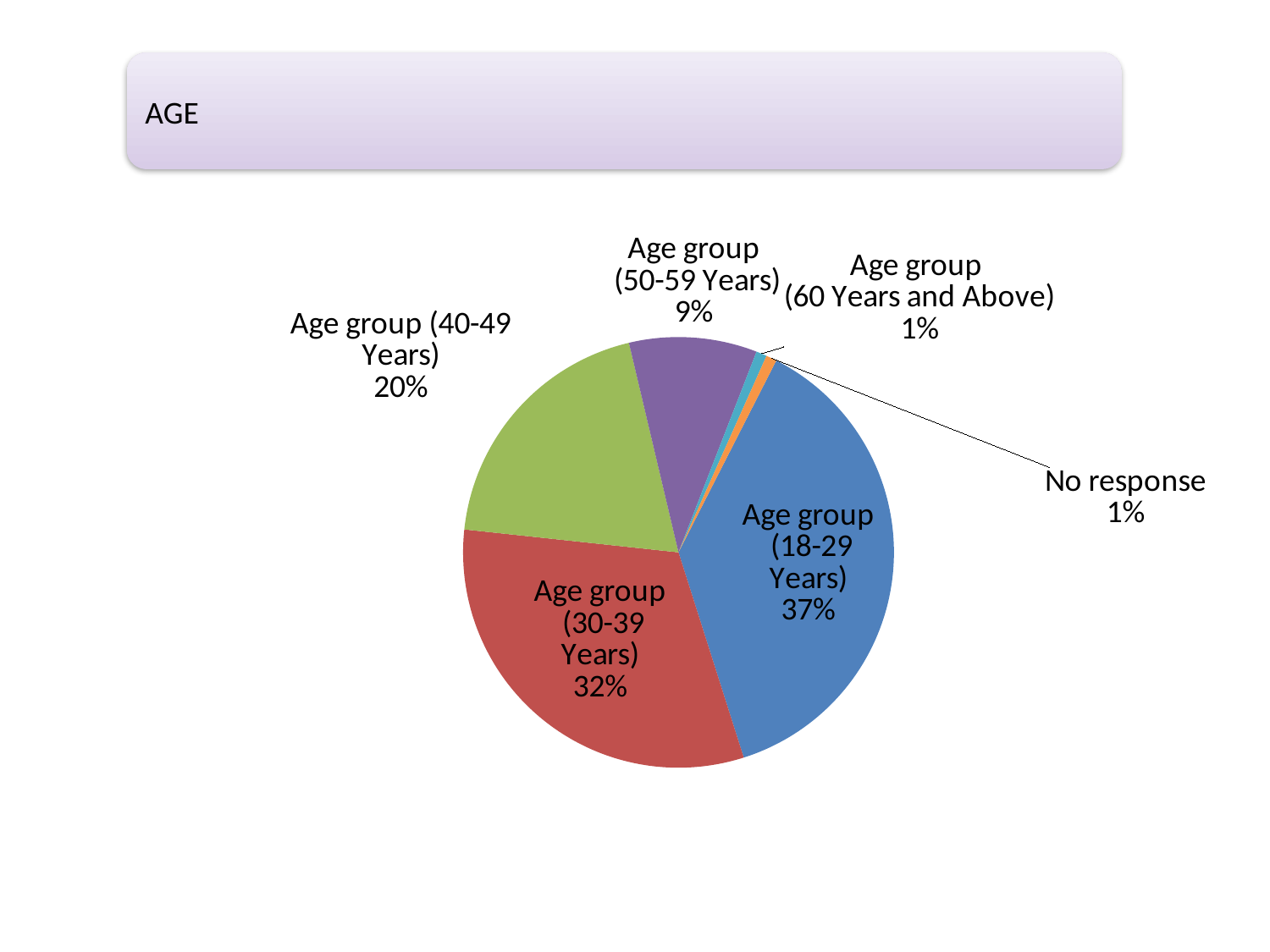
How many slices does the pie chart have? 6 What kind of chart is shown on the slide? pie chart What share of the pie is the Age group (18-29 Years) slice? 37% What is the difference in percentage points between the Age group (18-29 Years) slice and the Age group (30-39 Years) slice? 5% What share of the pie is the Age group (60 Years and Above) slice? 1% What share of the pie is the Age group (50-59 Years) slice? 9% What colour is the Age group (40-49 Years) slice? green Which category has the largest slice of the pie? Age group (18-29 Years) What is the combined share of the Age group (18-29 Years) and Age group (30-39 Years) slices? 69% Which is larger, the Age group (40-49 Years) slice or the Age group (50-59 Years) slice? Age group (40-49 Years)